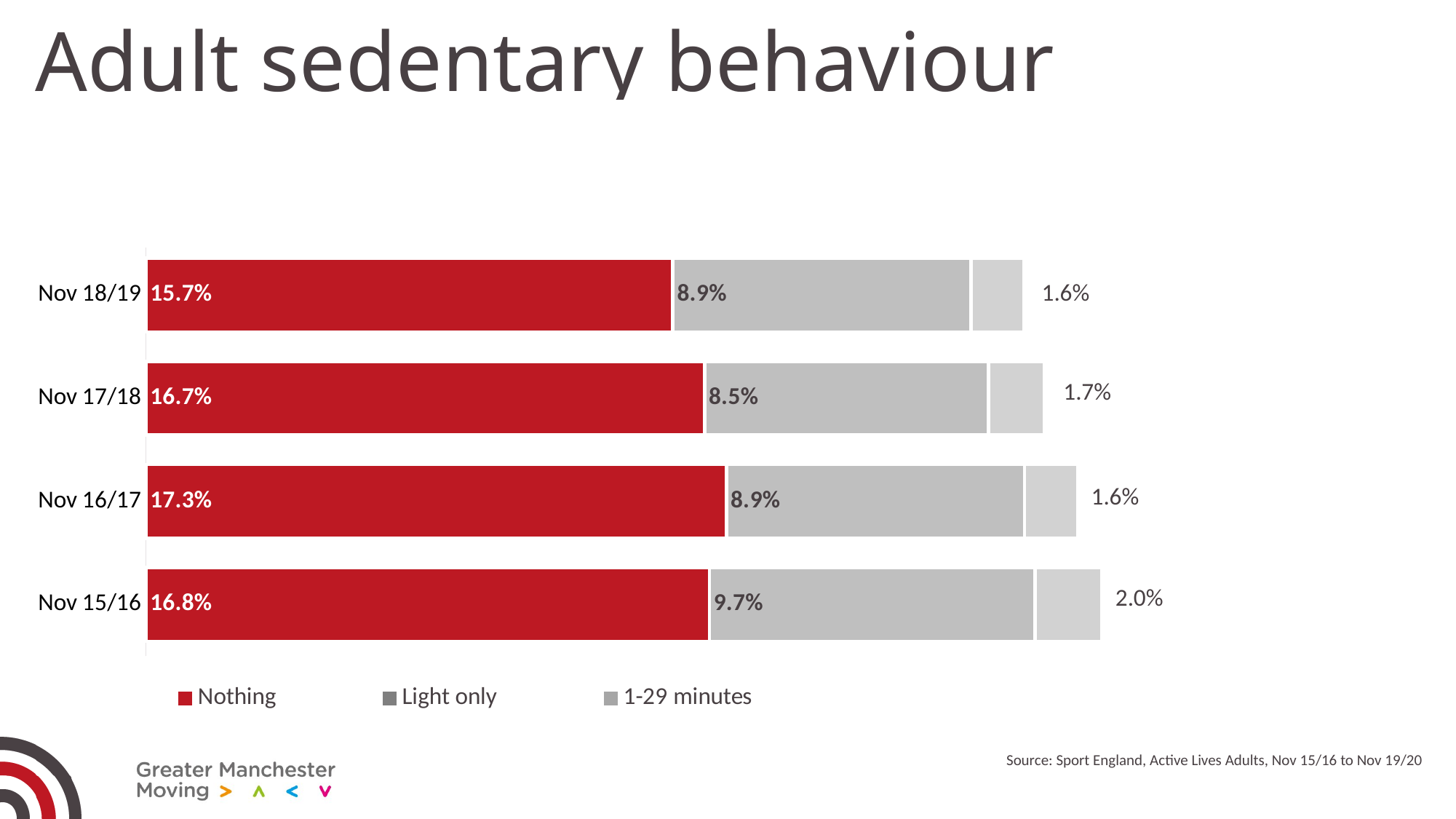
What is the 'Nothing' value for Nov 18/19? 15.7% What is the total of the stacked bar for Nov 15/16? 28.5% How many periods are shown on the chart? 4 What is the title of the chart? Adult sedentary behaviour Which period has the lowest 'Nothing' value? Nov 18/19 What is the difference between the 'Nothing' values for Nov 16/17 and Nov 18/19? 1.6% How many series does the legend list? 3 What is the '1-29 minutes' value for Nov 17/18? 1.7% Which period has the highest 'Nothing' value? Nov 16/17 What kind of chart is shown on the slide? Stacked bar chart What is the 'Light only' value for Nov 15/16? 9.7% Which is larger, the 'Light only' value for Nov 15/16 or for Nov 17/18? Nov 15/16